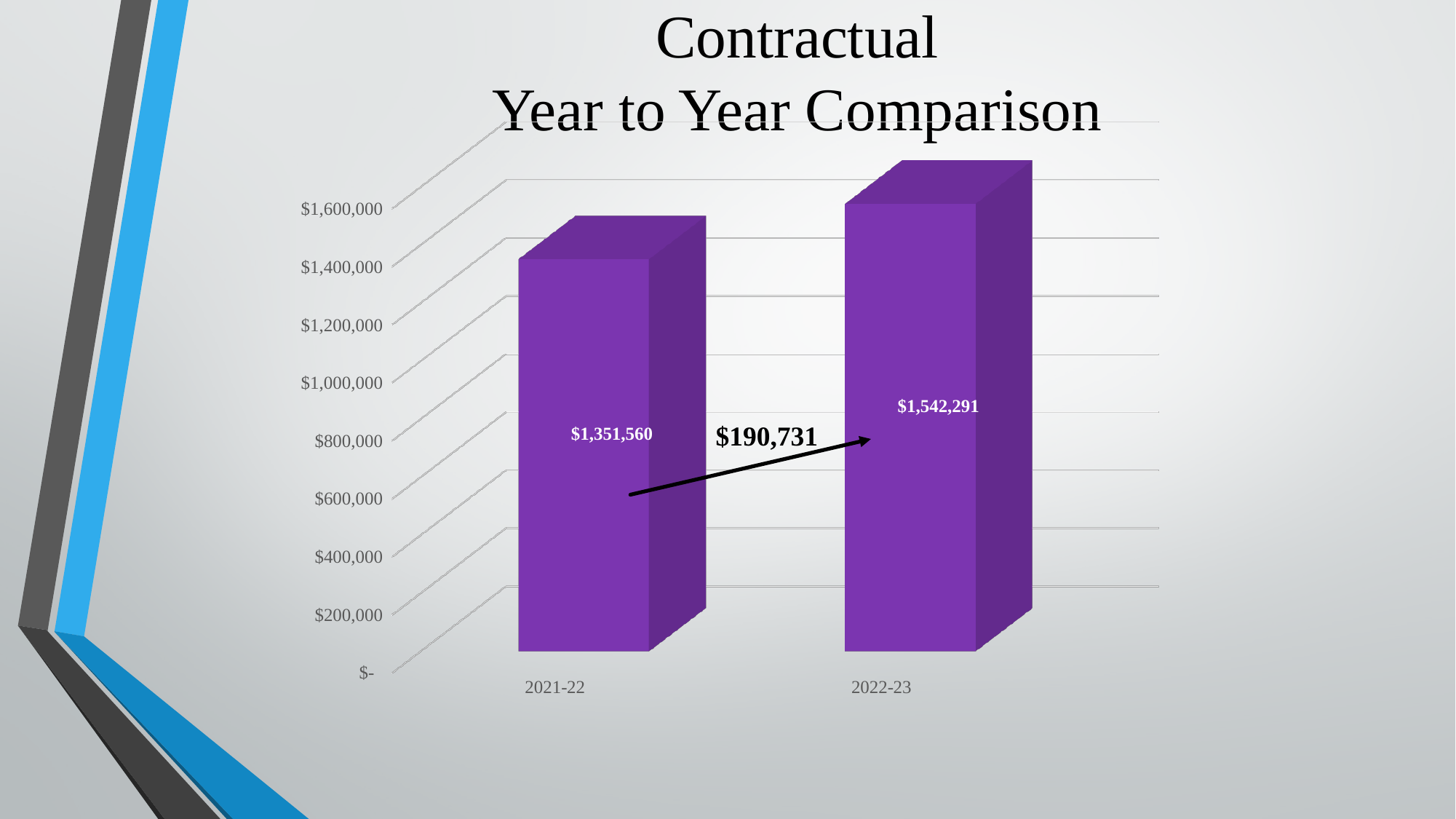
Do the values rise or fall from 2021-22 to 2022-23? Rise Is the value for 2022-23 greater or less than $1,400,000? greater What is the value for 2021-22? $1,351,560 What kind of chart is shown? Bar chart How many categories are shown on the x axis? 2 Is the value for 2022-23 larger than the value for 2021-22? Yes Which year has the lower value? 2021-22 What is the difference between the 2022-23 and 2021-22 values? $190,731 What is the title of the chart? Contractual Year to Year Comparison Which year has the higher value? 2022-23 Is the value for 2021-22 greater or less than $1,400,000? less What is the value for 2022-23? $1,542,291